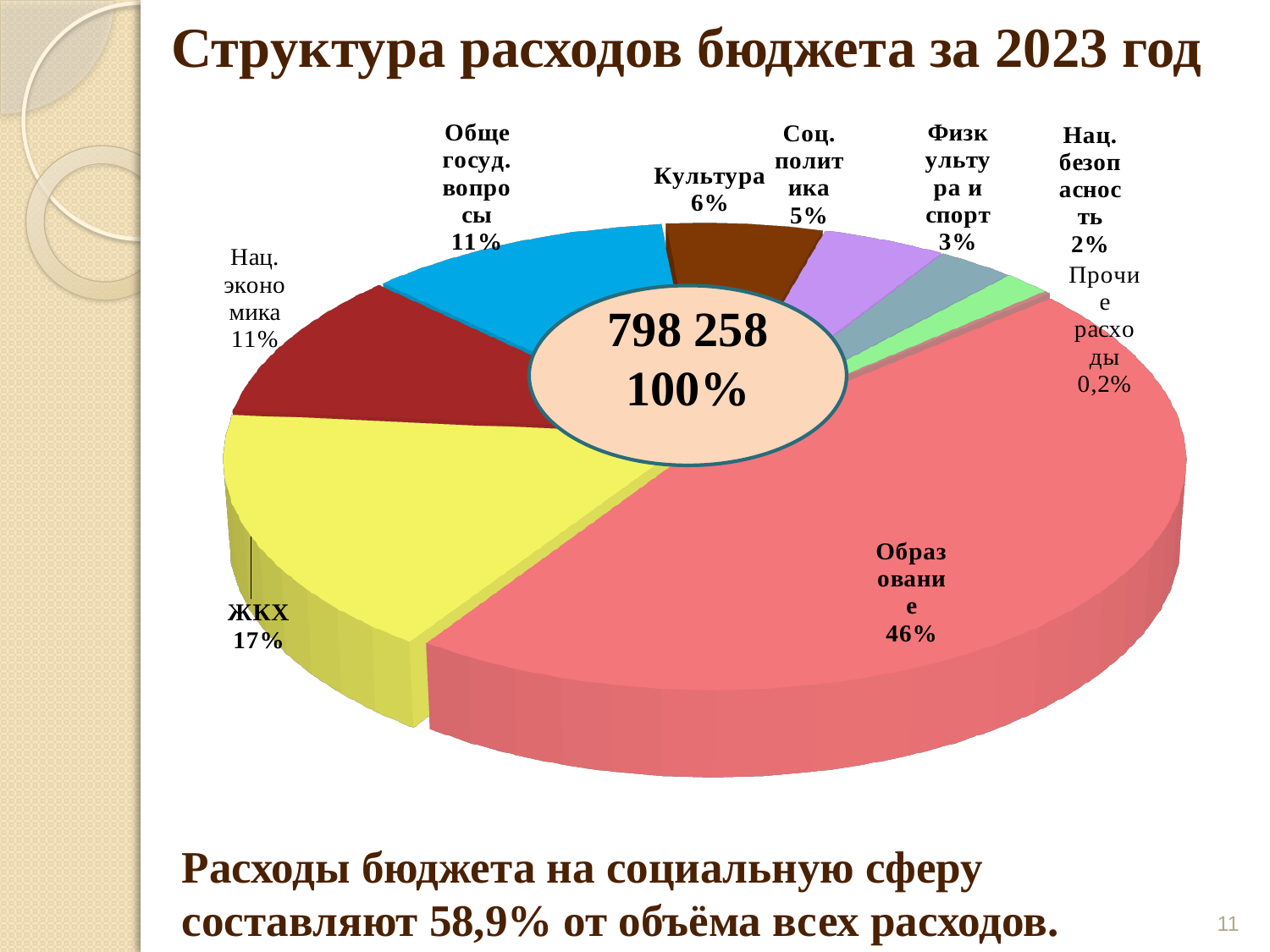
Which is larger, the share for Соц. политика or the share for Физкультура и спорт? Соц. политика What share is shown for Прочие расходы? 0,2% What is the title of the chart? Структура расходов бюджета за 2023 год How many slices does the pie chart have? 9 What share of budget expenditure does ЖКХ account for? 17% What kind of chart is shown on the slide? pie chart What is the difference in percentage points between Образование and ЖКХ? 29 Which category has the largest share of the pie? Образование What share is shown for Культура? 6% What total value is printed in the centre of the pie chart? 798 258 What share of budget expenditure does Образование account for? 46% Which category has the smallest share of the pie? Прочие расходы